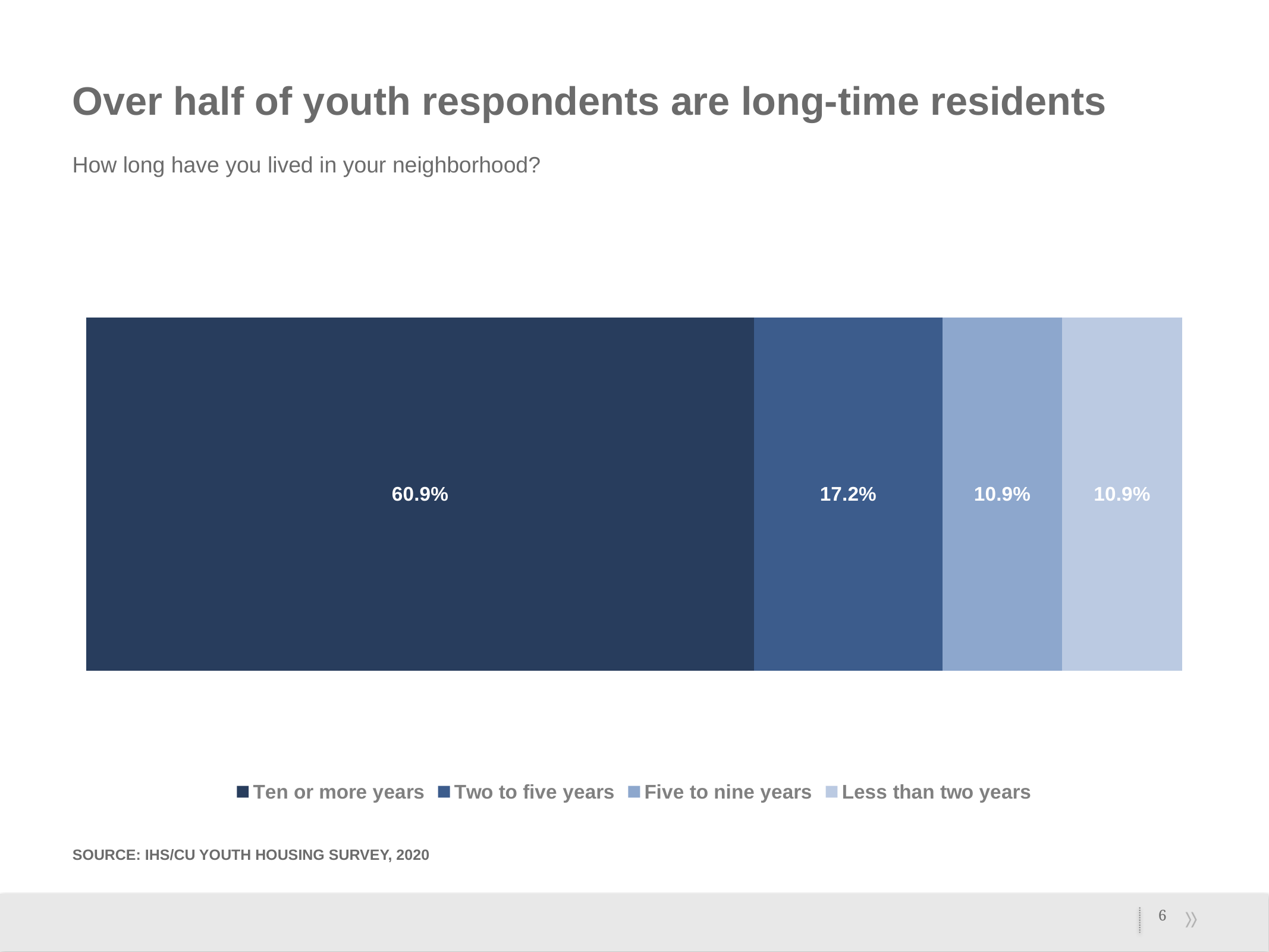
What percentage of youth respondents have lived in their neighborhood for ten or more years? 60.9% What is the total of all four segments in the stacked bar? 99.9% How many series does the legend list? 4 What is the difference in percentage points between the 'Ten or more years' and 'Two to five years' segments? 43.7 What percentage of respondents have lived in their neighborhood for less than two years? 10.9% What percentage of respondents have lived in their neighborhood for five to nine years? 10.9% What survey question does the chart present responses to? How long have you lived in your neighborhood? What is the source cited for the chart data? IHS/CU Youth Housing Survey, 2020 What kind of chart is shown on the slide? Stacked bar chart Which residency length category has the largest share of respondents? Ten or more years Which is larger: the share for 'Two to five years' or the share for 'Five to nine years'? Two to five years What percentage of respondents have lived in their neighborhood for two to five years? 17.2%